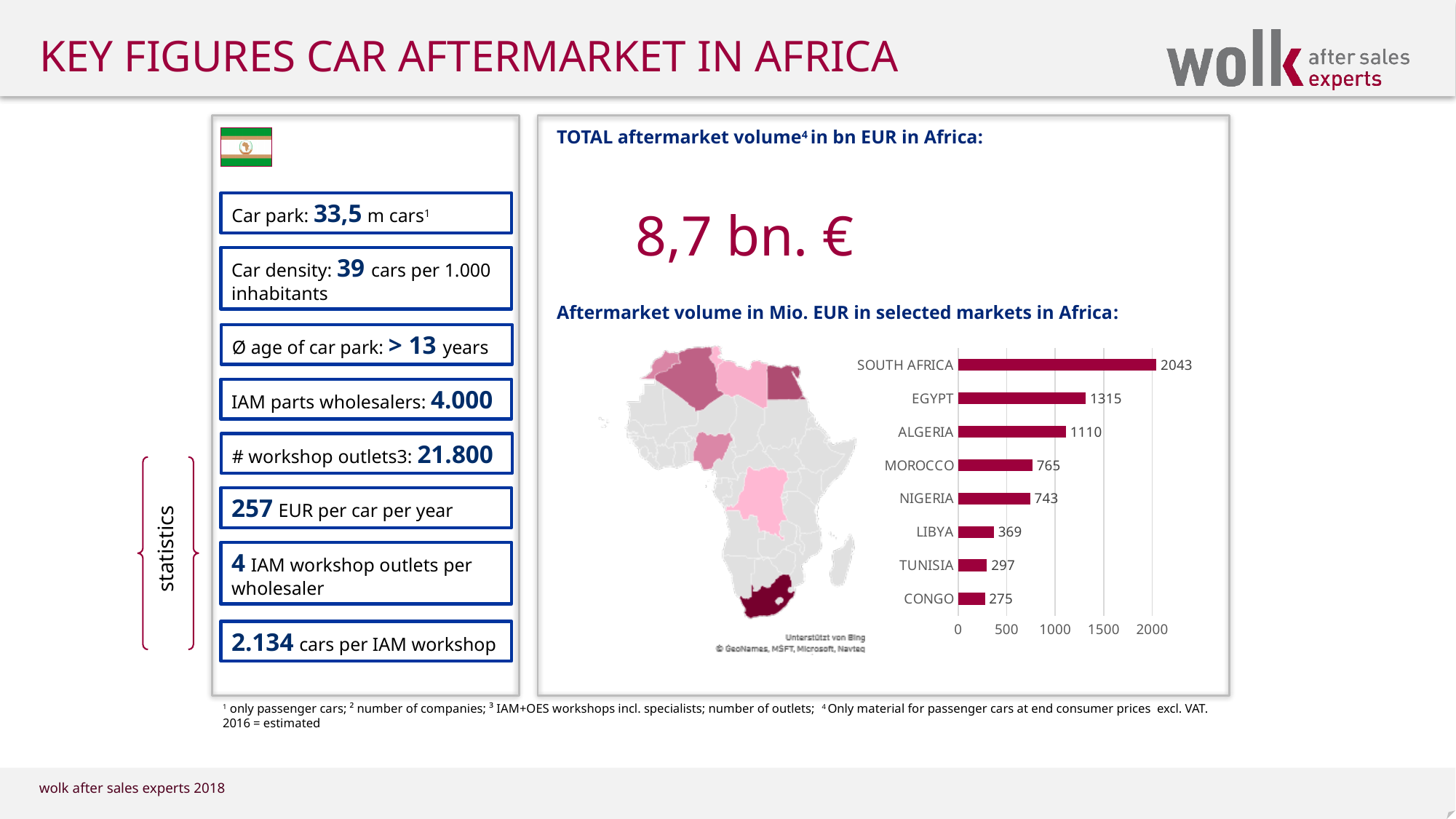
Which market has the highest aftermarket volume in the bar chart? South Africa How many markets are shown in the bar chart? 8 What is the difference in aftermarket volume between South Africa and Egypt? 728 What is the title of the bar chart? Aftermarket volume in Mio. EUR in selected markets in Africa What is the aftermarket volume in Mio. EUR for Egypt? 1315 What kind of chart is used to show the aftermarket volume in selected markets? Bar chart What is the aftermarket volume in Mio. EUR for Nigeria? 743 What is the difference in aftermarket volume between Morocco and Nigeria? 22 What is the aftermarket volume in Mio. EUR for Congo? 275 Which has a larger aftermarket volume, Algeria or Morocco? Algeria What is the aftermarket volume in Mio. EUR for South Africa? 2043 Which market has the lowest aftermarket volume in the bar chart? Congo